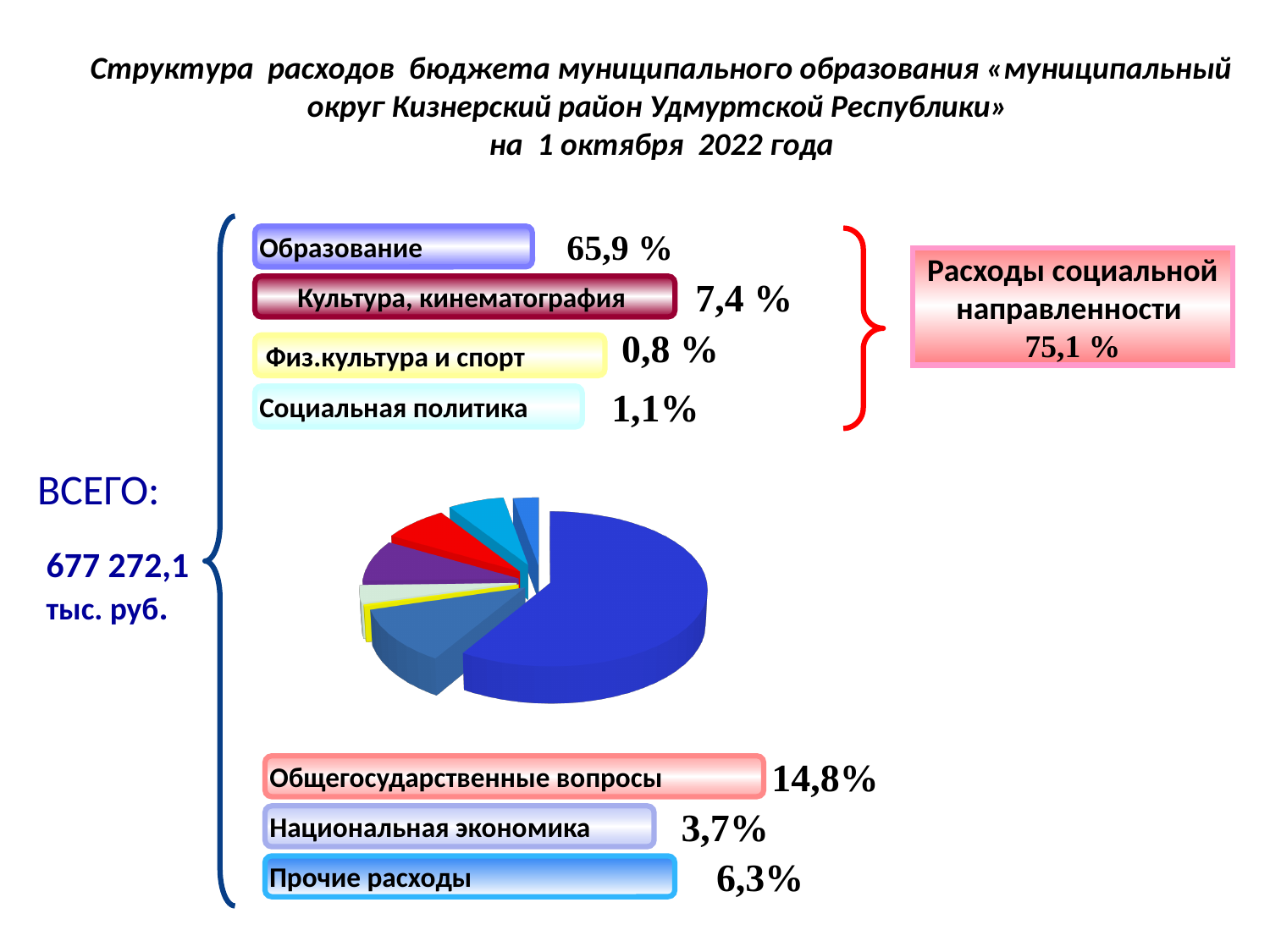
What percentage is shown for Социальная политика? 1,1% Which expenditure category has the largest share of the budget? Образование Which is larger: the share for Национальная экономика or for Прочие расходы? Прочие расходы How many expenditure categories are listed around the pie chart? 7 Which expenditure category has the smallest share of the budget? Физ.культура и спорт What percentage is shown for Общегосударственные вопросы? 14,8% What percentage is shown for Национальная экономика? 3,7% By how many percentage points does Образование exceed Общегосударственные вопросы? 51,1 % What percentage is shown for Культура, кинематография? 7,4 % What is the total budget expenditure (ВСЕГО) shown on the slide? 677 272,1 тыс. руб. What type of chart is shown on the slide? Pie chart What share of budget expenditures goes to Образование (education)? 65,9 %